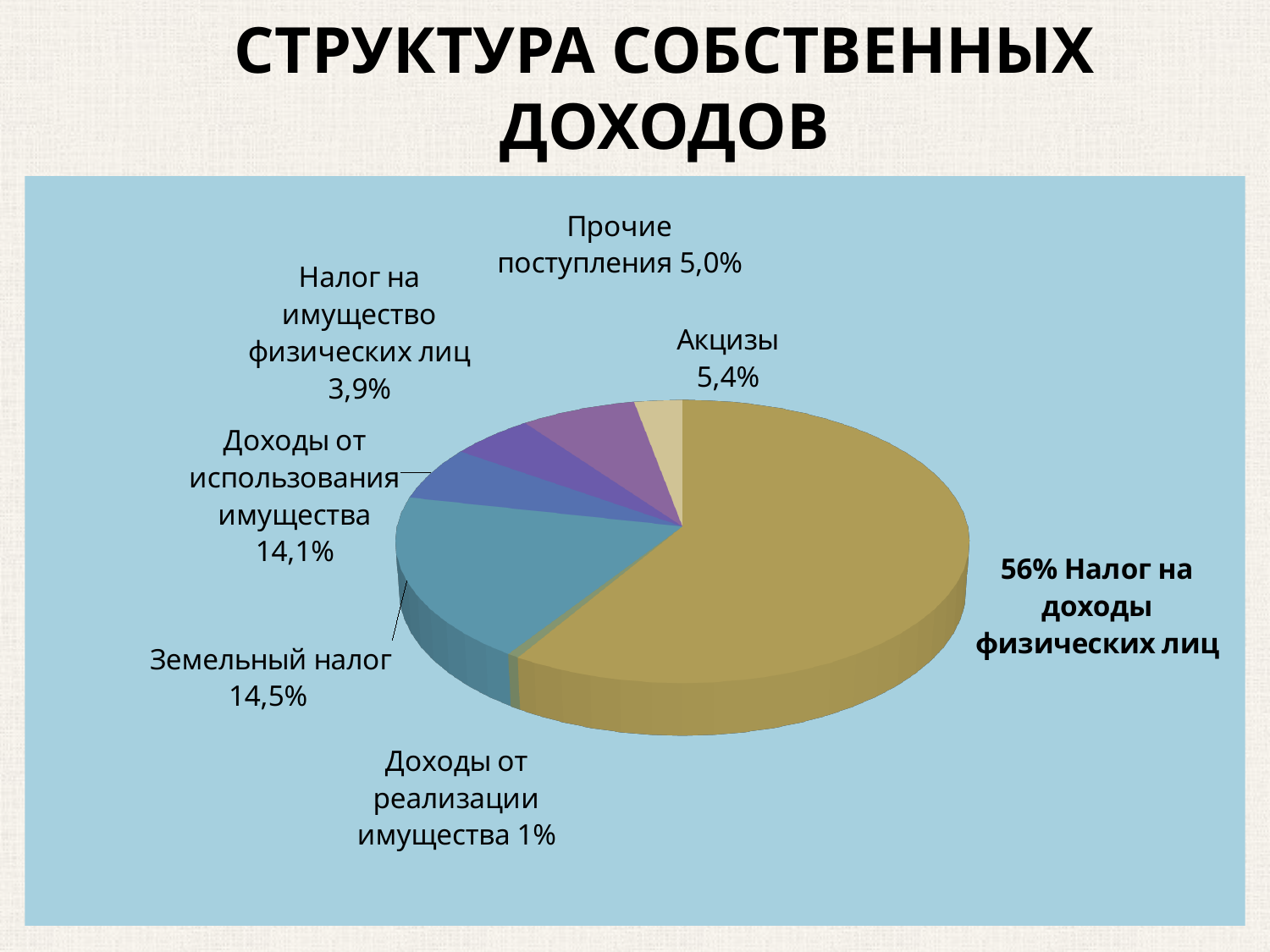
What is the value shown for Акцизы? 5,4% What is the value shown for Доходы от использования имущества? 14,1% What is the value shown for Налог на имущество физических лиц? 3,9% What kind of chart is shown on the slide? Pie chart Which category has the smallest slice of the pie? Доходы от реализации имущества What is the title of the slide? СТРУКТУРА СОБСТВЕННЫХ ДОХОДОВ Which is larger, Акцизы or Прочие поступления? Акцизы How many categories are shown in the pie chart? 7 Which category has the largest slice of the pie? Налог на доходы физических лиц What is the difference between the values for Земельный налог and Доходы от использования имущества? 0,4% What share of the pie does Налог на доходы физических лиц have? 56% What is the value shown for Земельный налог? 14,5%